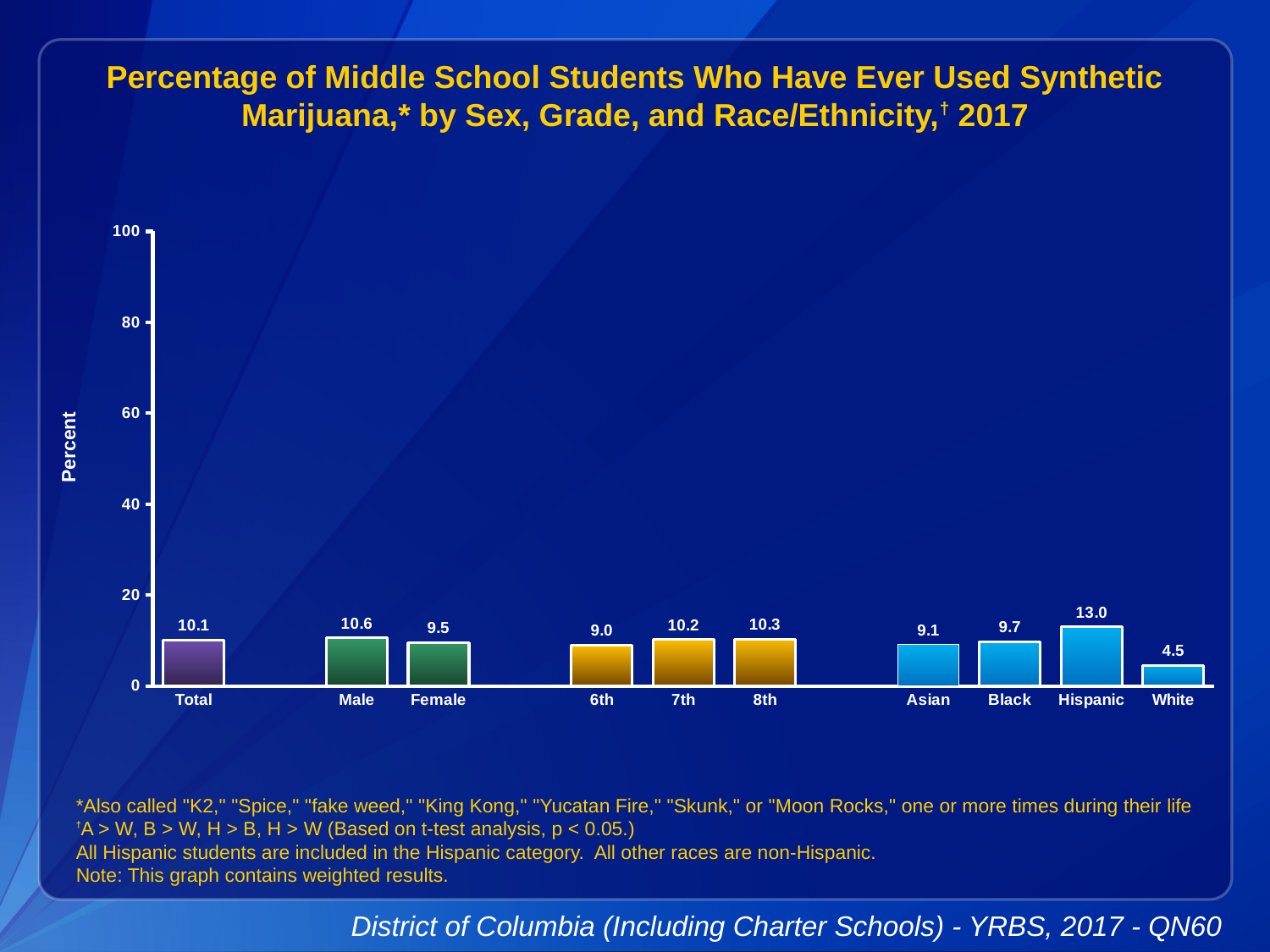
What is the label on the y axis? Percent What is the value for Hispanic students? 13.0 Which category has the highest value? Hispanic What is the value for Total? 10.1 Which is larger, the value for 7th grade or 8th grade? 8th Do the values rise or fall from 6th grade to 8th grade? rise Which category has the lowest value? White How many categories are shown on the x axis? 10 What is the difference between the Male and Female values? 1.1 What kind of chart is this? bar chart Is the value for Black students greater or less than 20? less What is the value for 6th grade? 9.0